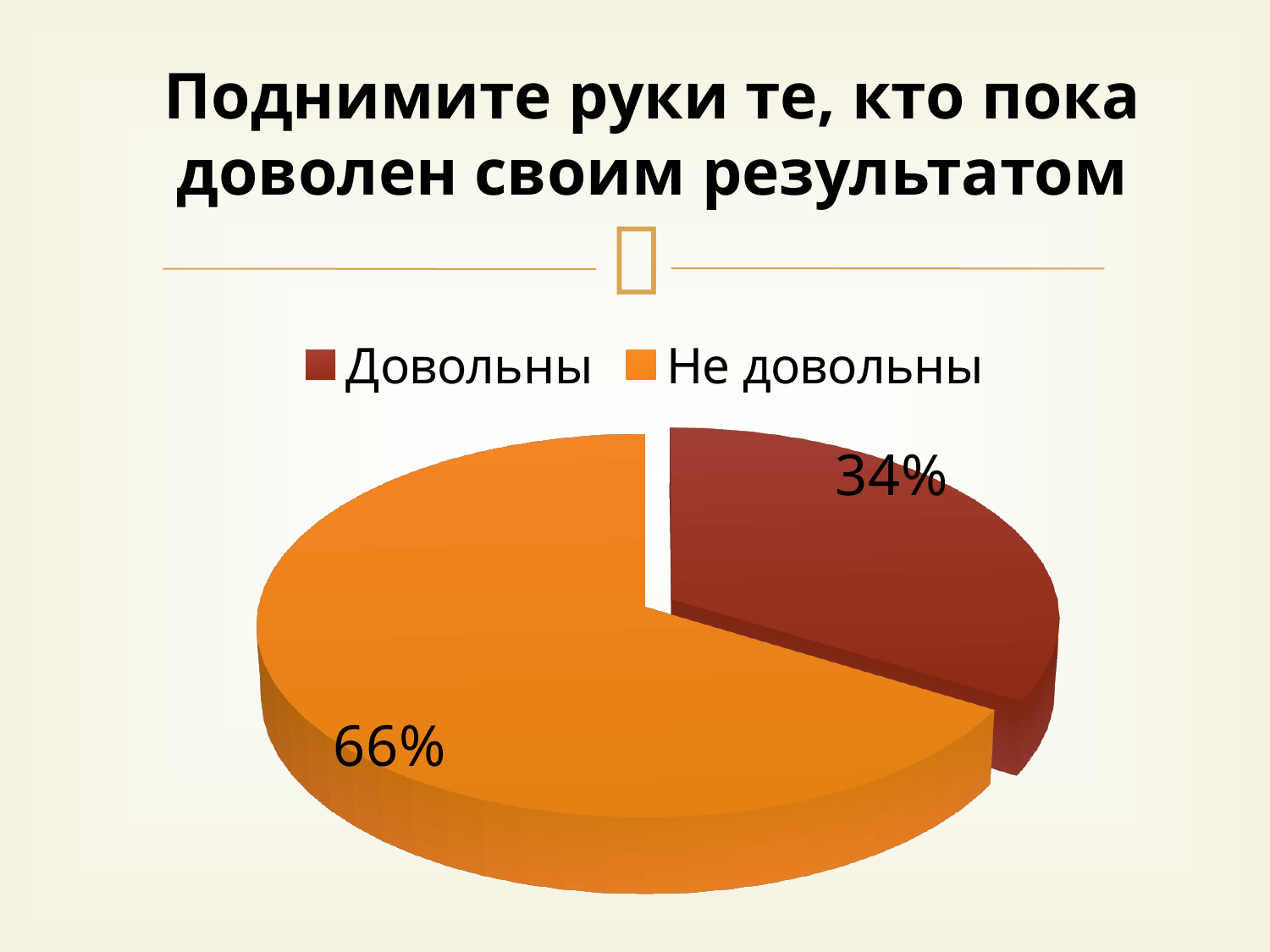
What kind of chart is shown on the slide? pie chart What colour is the "Не довольны" slice? orange Which slice is the smallest? Довольны What share of the pie is labelled "Довольны"? 34% How many entries does the legend list? 2 How many slices does the pie chart have? 2 What colour is the "Довольны" slice? dark red Which is larger, the "Довольны" slice or the "Не довольны" slice? Не довольны What is the difference in percentage points between the "Не довольны" and "Довольны" slices? 32 What share of the pie is labelled "Не довольны"? 66% Which slice is the largest? Не довольны